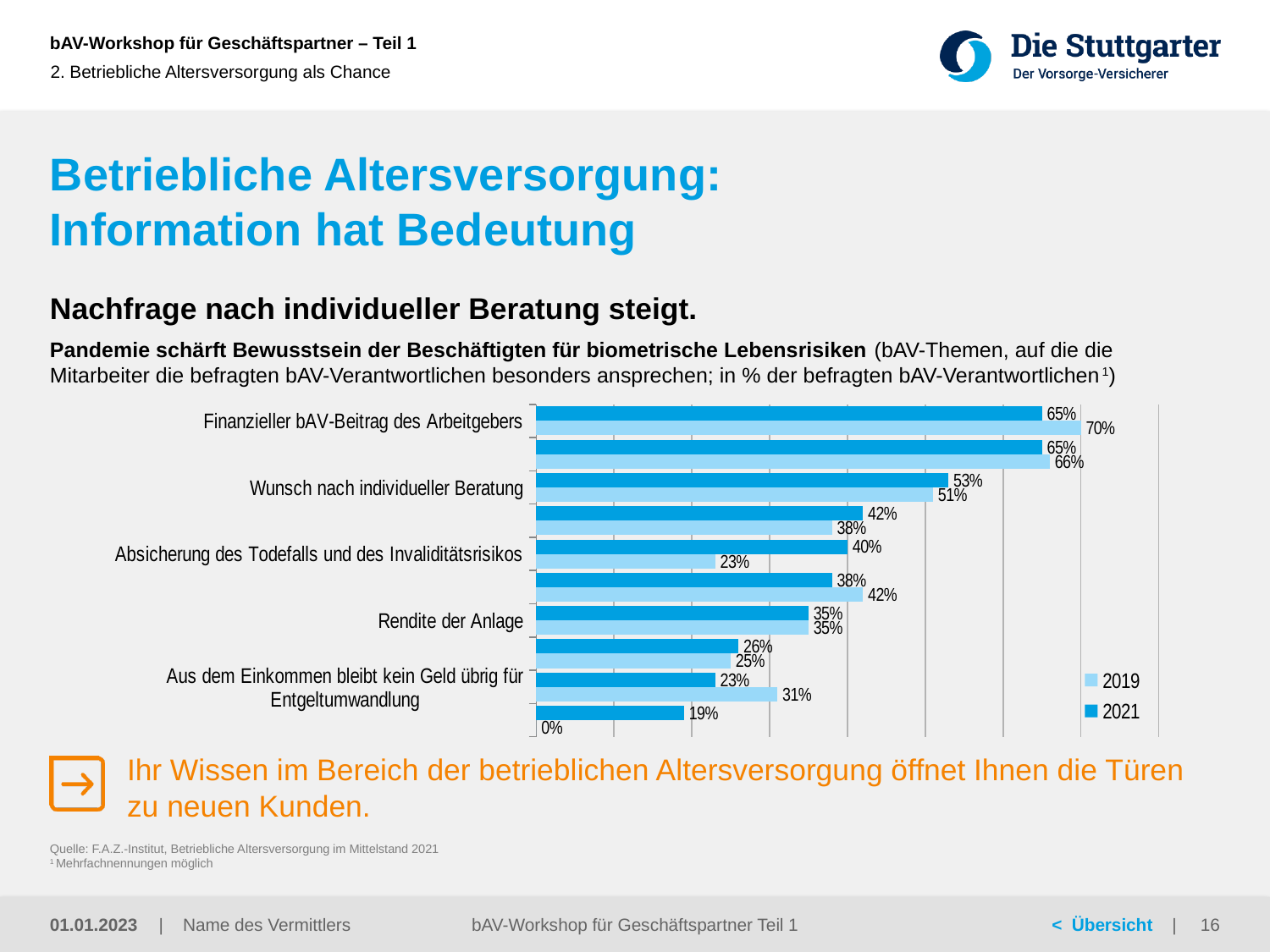
What is the 2019 value for "Aus dem Einkommen bleibt kein Geld übrig für Entgeltumwandlung"? 31% Which is larger for "Wunsch nach individueller Beratung": the 2019 value or the 2021 value? 2021 Which colour represents the 2021 series in the legend? dark blue Which labelled category has the highest 2019 value? Finanzieller bAV-Beitrag des Arbeitgebers What is the 2021 value for "Absicherung des Todesfalls und des Invaliditätsrisikos"? 40% What is the 2021 value for "Finanzieller bAV-Beitrag des Arbeitgebers"? 65% What is the 2021 value for "Wunsch nach individueller Beratung"? 53% What is the 2019 value for "Absicherung des Todesfalls und des Invaliditätsrisikos"? 23% How many series does the chart legend list? 2 What type of chart is shown on the slide? bar chart By how many percentage points did "Absicherung des Todesfalls und des Invaliditätsrisikos" change from 2019 to 2021? 17 percentage points What is the 2019 value for "Finanzieller bAV-Beitrag des Arbeitgebers"? 70%